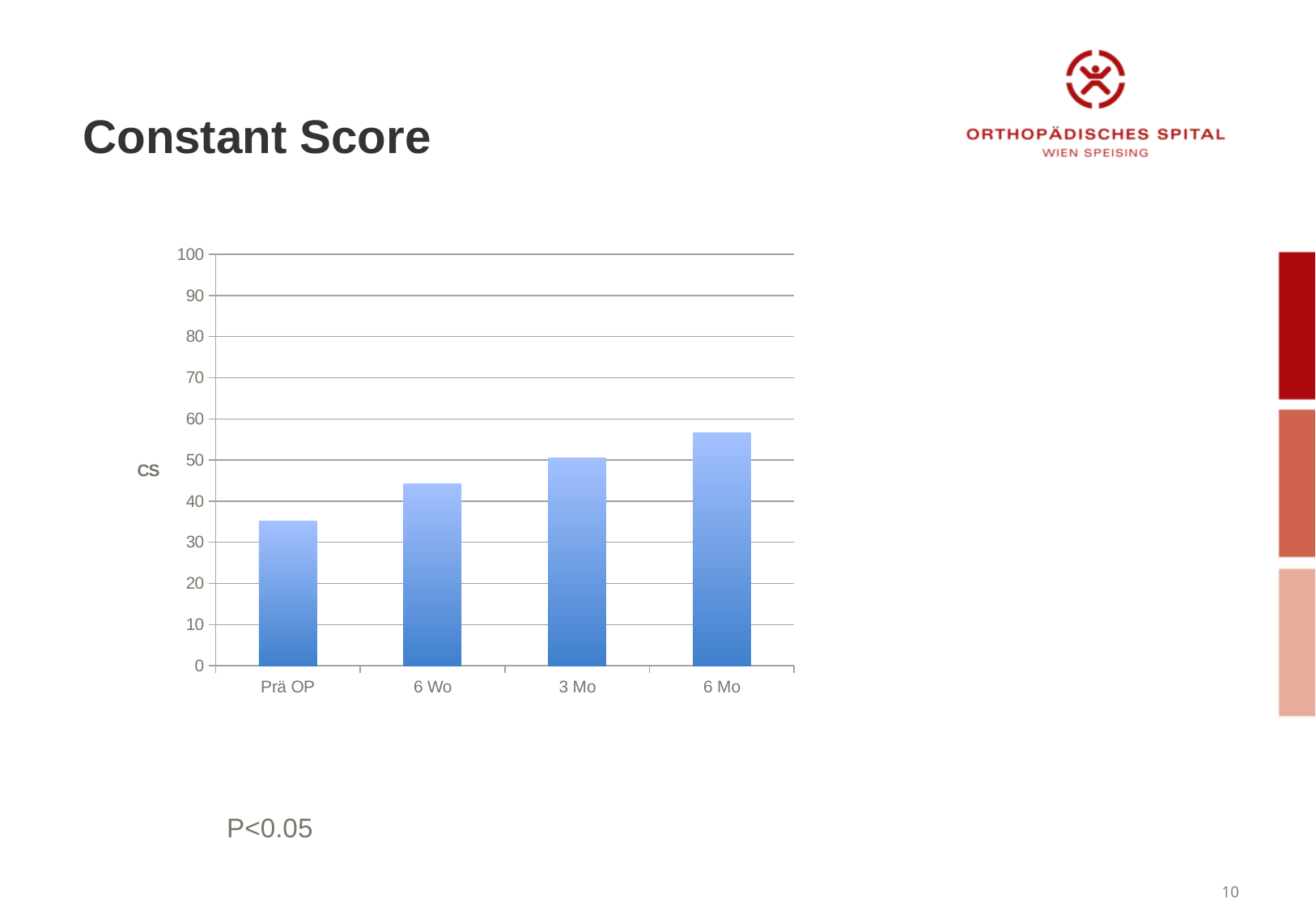
Do the values rise or fall from Prä OP to 6 Mo along the x axis? rise Which is larger, the value for Prä OP or the value for 6 Mo? 6 Mo Is the value for Prä OP greater or less than 40? less Is the value for 6 Wo greater or less than 40? greater Is the value for Prä OP greater or less than 30? greater What kind of chart is shown on the slide? bar chart How many categories are shown on the x axis of the chart? 4 What is the label on the vertical axis of the chart? CS Which category has the lowest value in the chart? Prä OP Which category has the highest value in the chart? 6 Mo Which is larger, the value for 6 Wo or the value for 6 Mo? 6 Mo